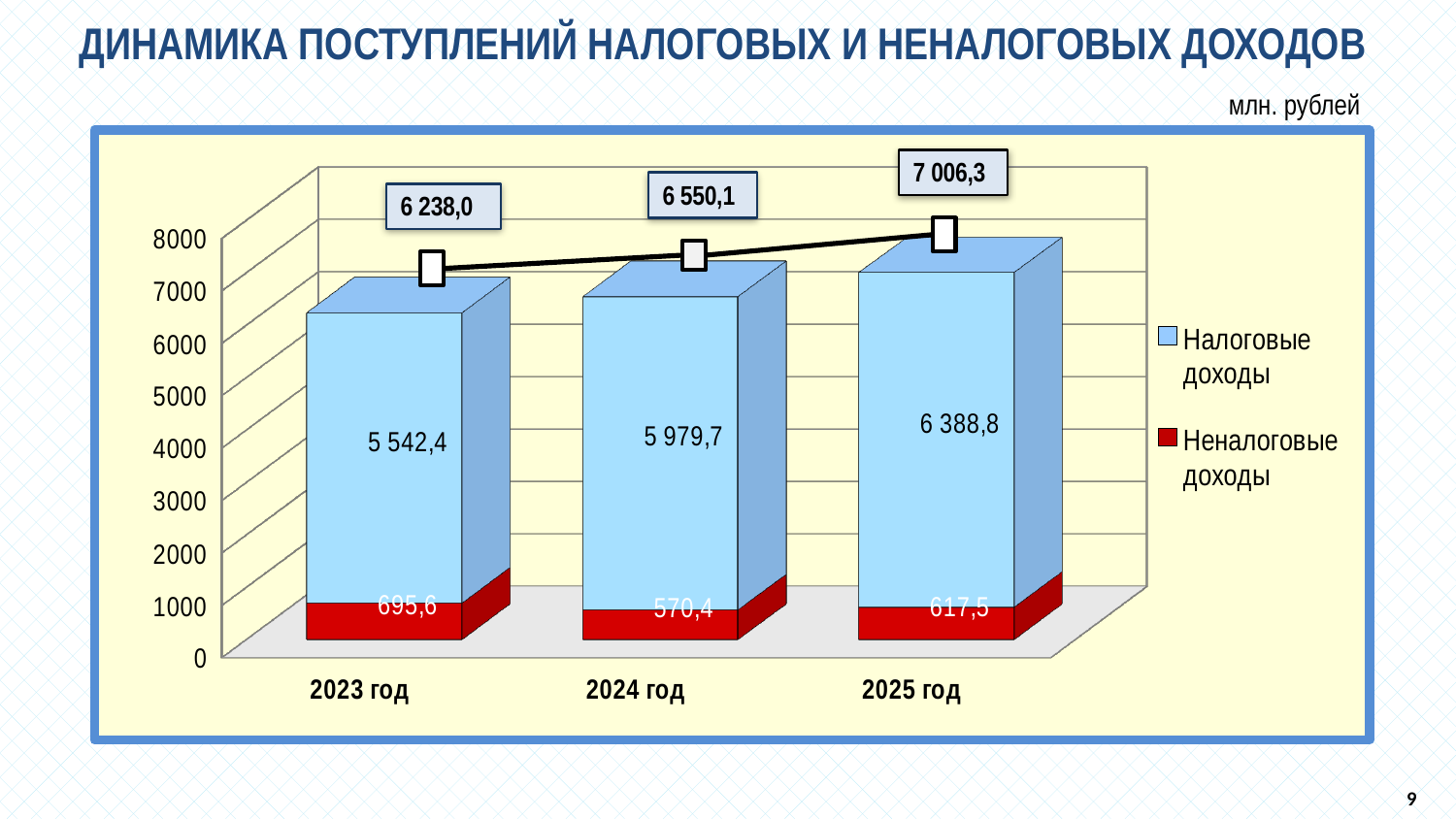
Which year has the lowest value of Неналоговые доходы? 2024 год What kind of chart is shown on the slide? Stacked bar chart What total is shown above the bar for 2025 год? 7 006,3 Which year has the highest value of Налоговые доходы? 2025 год What is the difference between the total for 2025 год and the total for 2023 год? 768,3 How many series does the legend list? 2 Do the totals shown above the bars rise or fall from 2023 год to 2025 год? Rise What is the value of Неналоговые доходы for 2024 год? 570,4 How many years are shown on the x axis? 3 Which is larger: Неналоговые доходы in 2023 год or in 2025 год? 2023 год What is the difference between Налоговые доходы in 2024 год and 2023 год? 437,3 What is the value of Налоговые доходы for 2023 год? 5 542,4